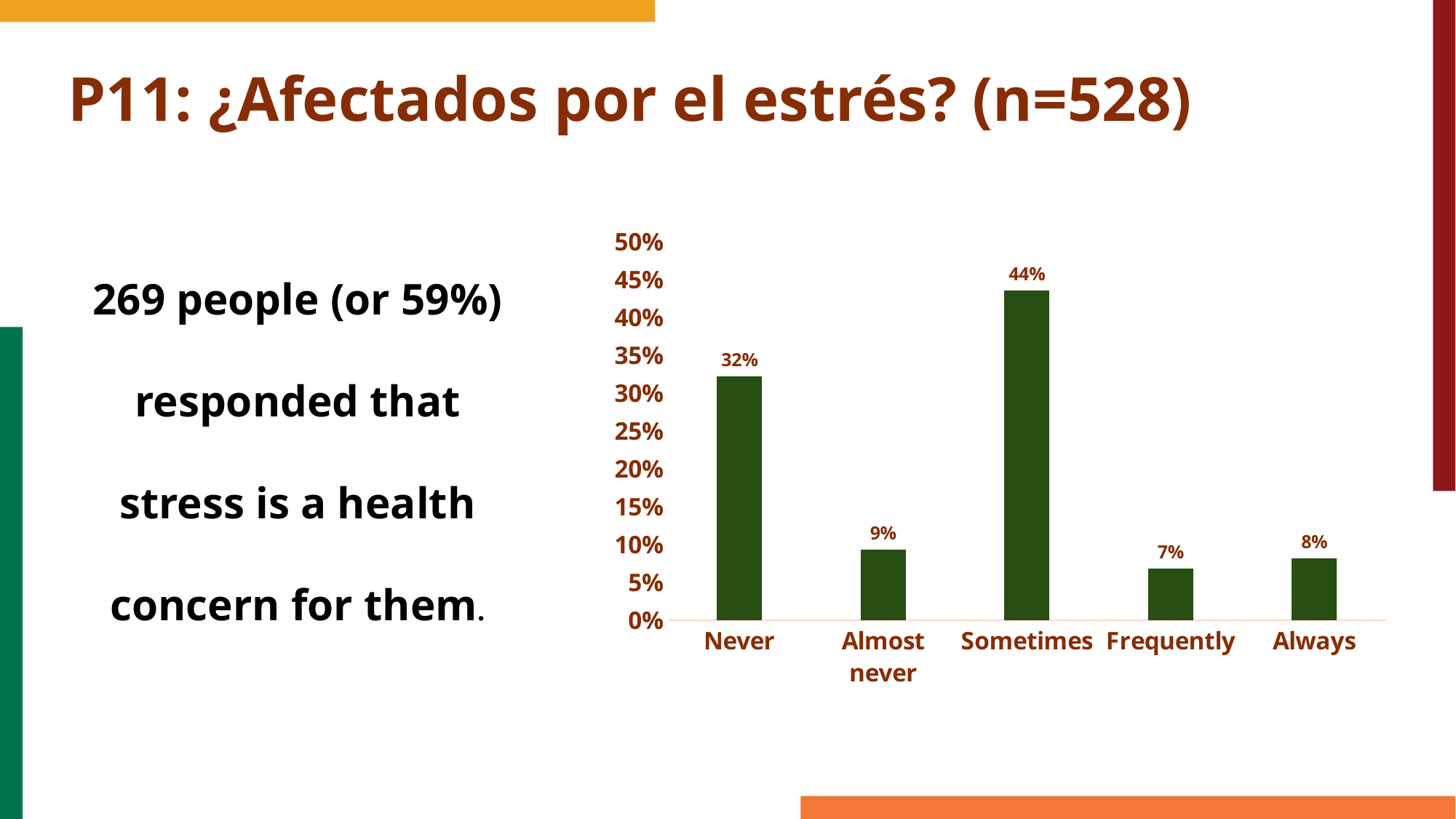
What kind of chart is shown on the slide? Bar chart What is the highest value shown on the y axis? 50% Which category has the highest value? Sometimes How many categories are shown on the x axis? 5 What is the value for Almost never? 9% Is the value for Never greater or less than 30%? greater Which is larger, the value for Almost never or the value for Always? Almost never What is the value for Never? 32% Which category has the lowest value? Frequently What is the difference between the values for Sometimes and Never? 12% What is the value for Sometimes? 44% What is the value for Frequently? 7%